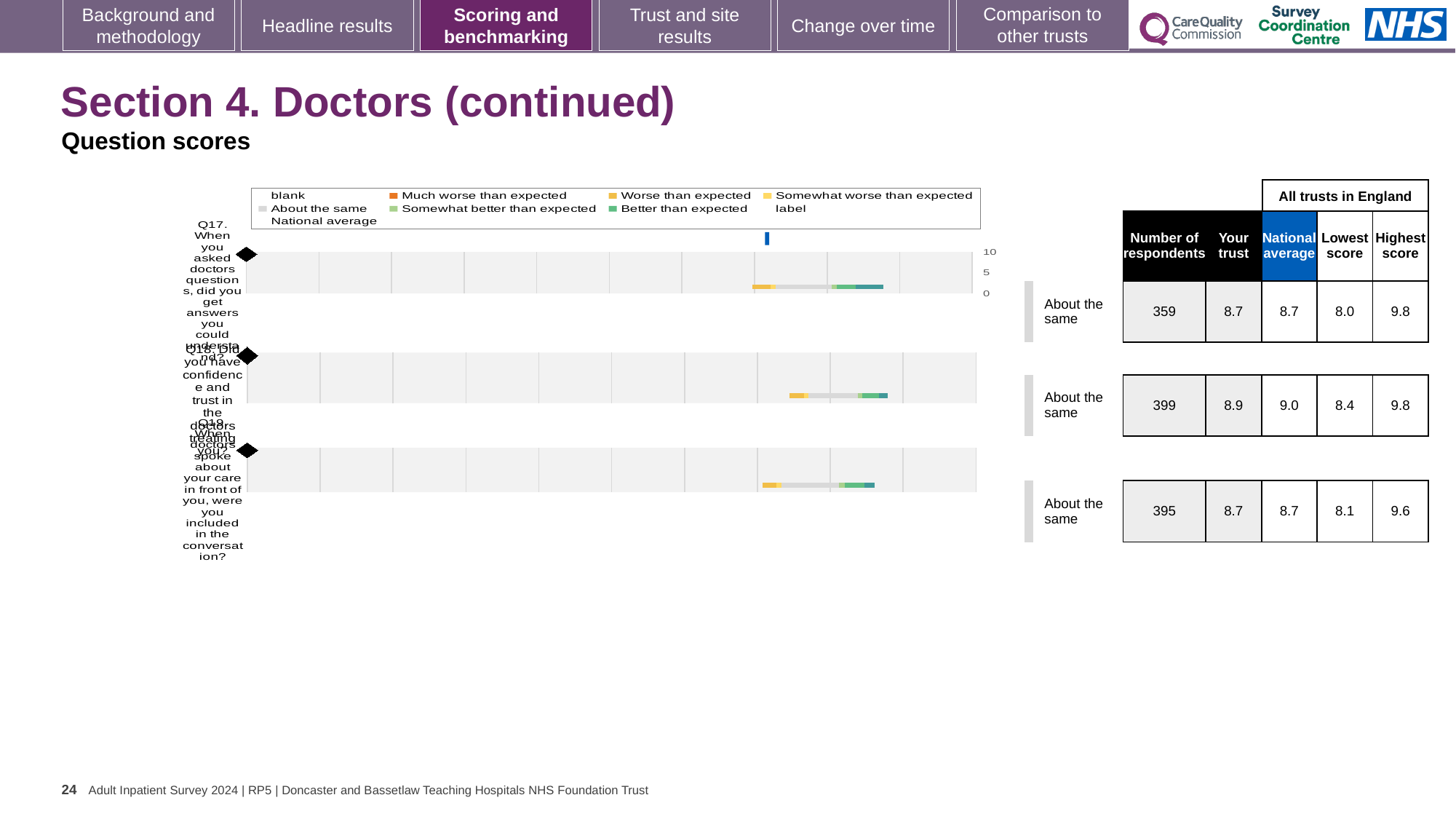
What is the number of respondents for Q17? 359 What is the highest tick value shown on the score axis of the Q17 chart? 10 For Q18, which is larger: the 'Your trust' score or the national average? National average What is the difference between the highest score and the lowest score for Q17? 1.8 What is the 'Your trust' score for Q18? 8.9 What is the difference between the highest score and the lowest score for Q18? 1.4 What is the lowest score across all trusts in England for Q19? 8.1 How many questions are plotted in the charts on this slide? 3 What is the national average score for Q19? 8.7 What benchmark category is shown next to each of the three questions? About the same What kind of chart is used to show the question scores for Q17, Q18 and Q19? bar chart Which question has the highest 'Your trust' score? Q18